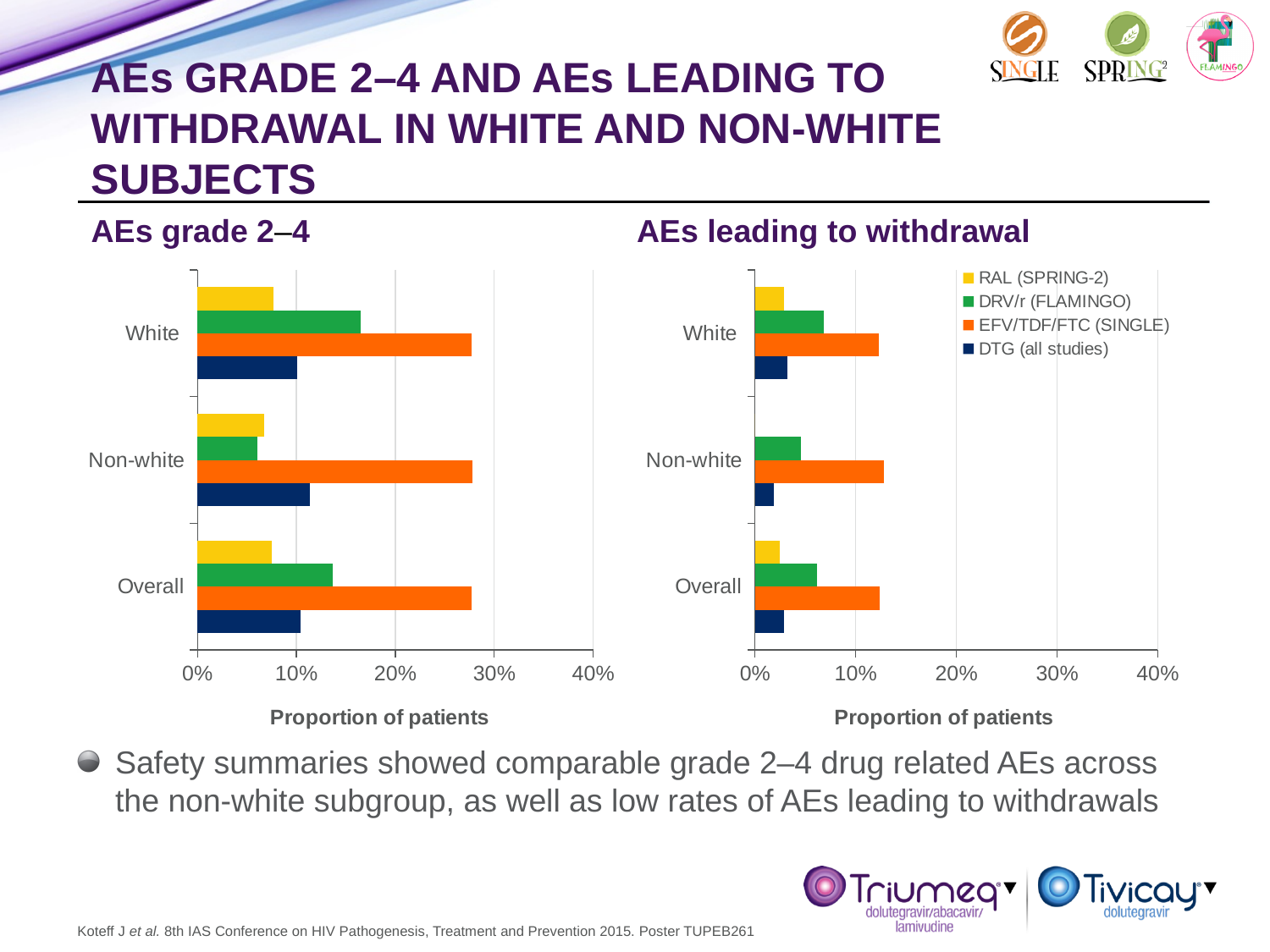
What kind of chart is the "AEs grade 2–4" chart? bar chart In the "AEs leading to withdrawal" chart, which series has the highest value for Non-white subjects? EFV/TDF/FTC (SINGLE) What is the x-axis title of the "AEs leading to withdrawal" chart? Proportion of patients How many categories are shown on the y axis of the "AEs leading to withdrawal" chart? 3 In the "AEs grade 2–4" chart, which is larger for DRV/r (FLAMINGO): the White value or the Non-white value? White In the "AEs grade 2–4" chart, is the value for DRV/r (FLAMINGO) in the White category greater or less than 10%? greater In the "AEs grade 2–4" chart, which series has the highest value for White subjects? EFV/TDF/FTC (SINGLE) In the "AEs grade 2–4" chart, is the value for DRV/r (FLAMINGO) in the Non-white category greater or less than 10%? less In the "AEs grade 2–4" chart, is the value for EFV/TDF/FTC (SINGLE) in the Overall category greater or less than 20%? greater How many series does the legend list for the "AEs leading to withdrawal" chart? 4